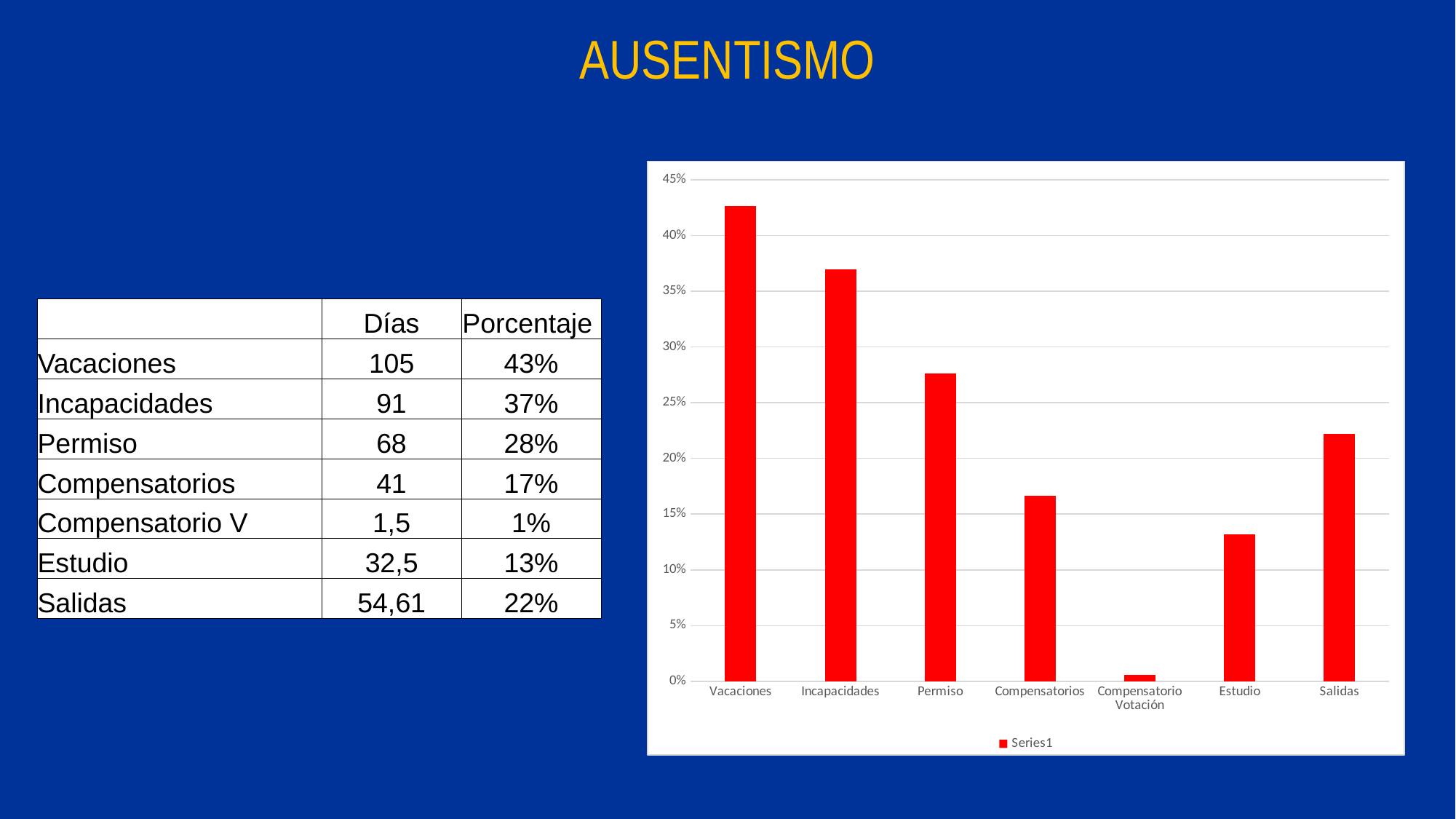
What kind of chart is shown on the slide? Bar chart What is the name of the series shown in the chart legend? Series1 Which category has the lowest bar in the chart? Compensatorio Votación Which is larger, the value for Salidas or the value for Estudio? Salidas Is the value for Compensatorio Votación greater or less than 5%? less Is the value for Salidas greater or less than 20%? greater Which is larger, the value for Permiso or the value for Compensatorios? Permiso Which category has the highest bar in the chart? Vacaciones How many categories are shown on the x axis of the chart? 7 How many series does the chart legend list? 1 Is the value for Vacaciones greater or less than 40%? greater